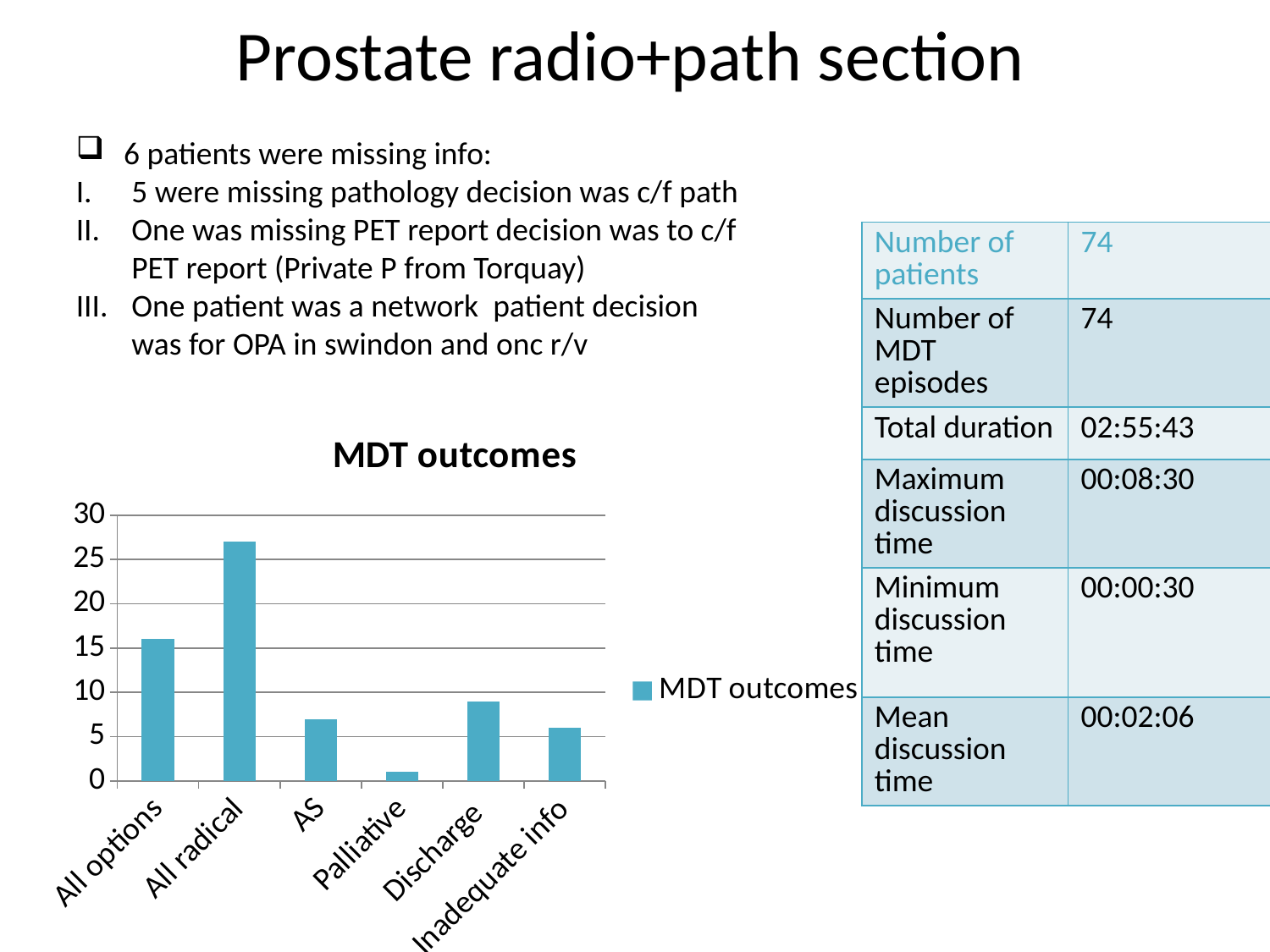
How many series does the legend of the MDT outcomes chart list? 1 Which is larger in the MDT outcomes chart, AS or Inadequate info? AS Which category has the highest value in the MDT outcomes chart? All radical Is the value for All radical greater or less than 25 in the MDT outcomes chart? greater What is the title of the chart on the slide? MDT outcomes Is the value for All options greater or less than 15 in the MDT outcomes chart? greater Which is larger in the MDT outcomes chart, All options or Discharge? All options What type of chart is the MDT outcomes chart? bar chart Is the value for Discharge greater or less than 10 in the MDT outcomes chart? less How many categories are shown on the x axis of the MDT outcomes chart? 6 Which category has the lowest value in the MDT outcomes chart? Palliative